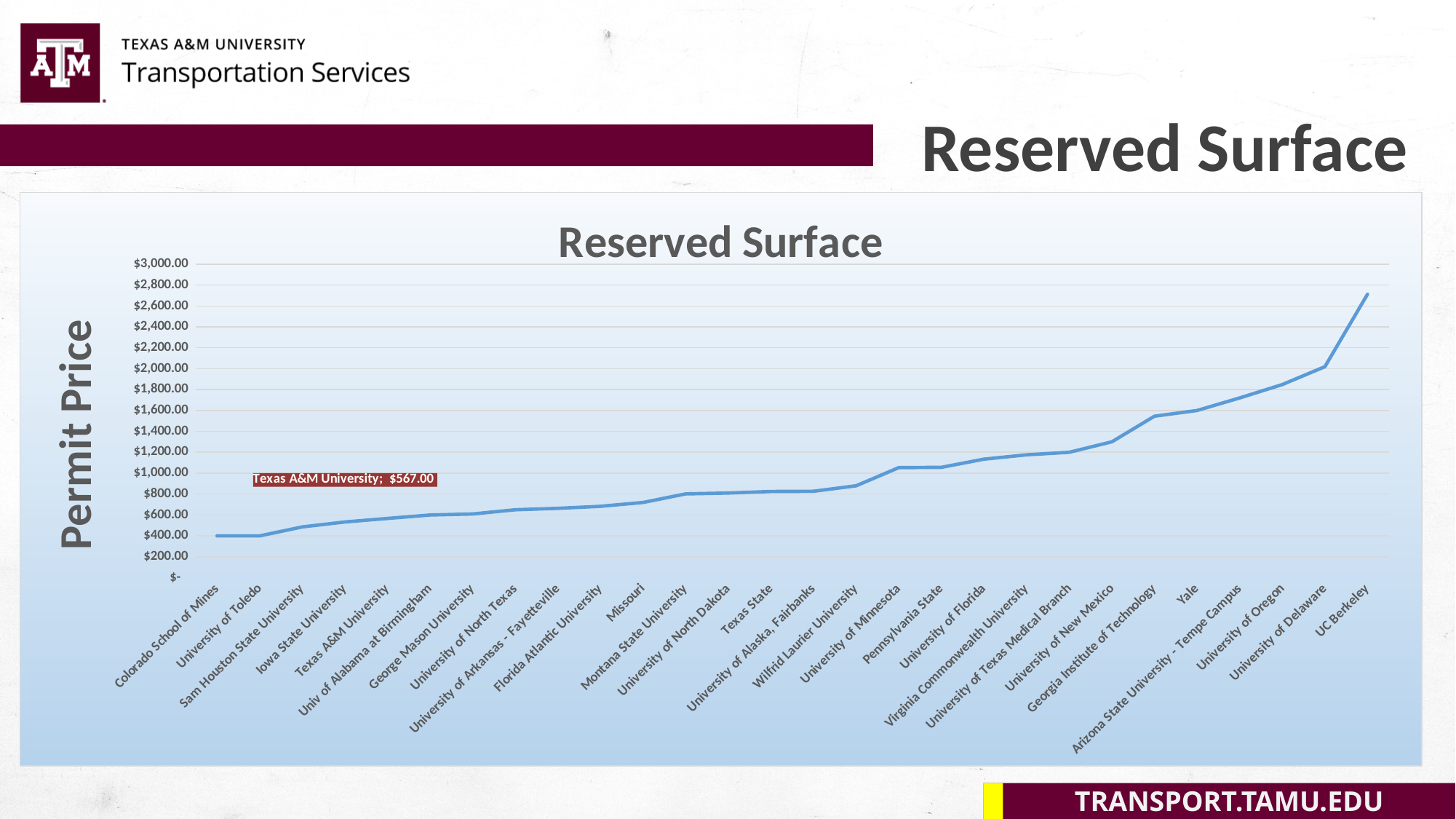
How many universities are plotted on the x axis? 28 Is the value for UC Berkeley greater or less than $2,000.00? greater Which university has the highest reserved surface permit price? UC Berkeley Is the value for University of Minnesota greater or less than $800.00? greater Which has a higher permit price, University of Oregon or Missouri? University of Oregon Is the value for Colorado School of Mines greater or less than $600.00? less What is the label on the vertical axis? Permit Price What is the permit price for Texas A&M University? $567.00 What is the title of the chart? Reserved Surface What kind of chart is shown on the slide? line chart Do the permit prices rise or fall moving left to right along the x axis? rise